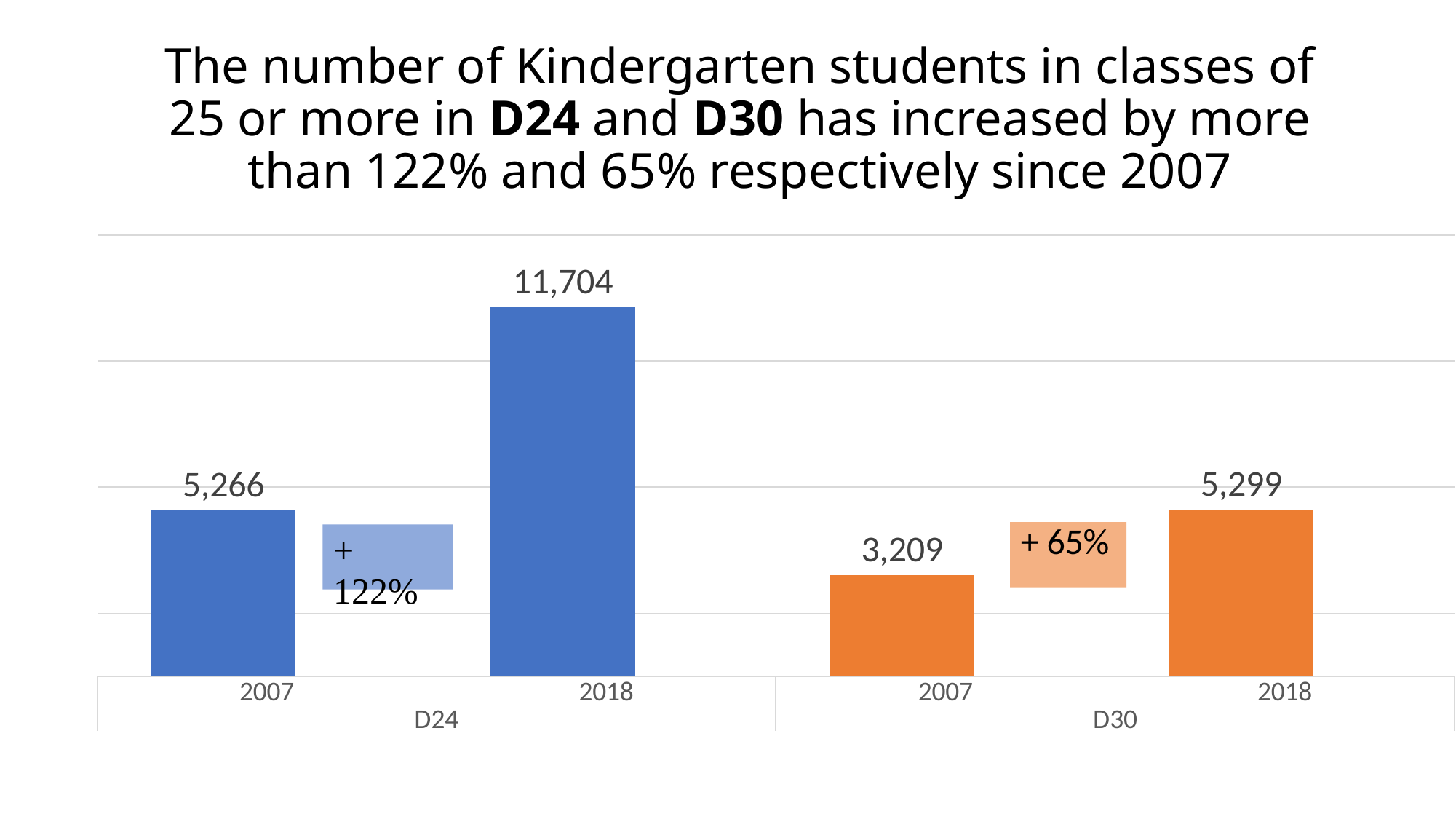
What is the value for D30 in 2007? 3,209 What is the value for D24 in 2018? 11,704 What is the difference between the D24 values for 2018 and 2007? 6,438 What is the value for D30 in 2018? 5,299 How many bars are plotted in the chart? 4 Which bar has the lowest value? D30 2007 What kind of chart is shown? Bar chart What is the difference between the D30 values for 2018 and 2007? 2,090 What is the value for D24 in 2007? 5,266 What percentage increase is annotated for D30? + 65% Which bar has the highest value? D24 2018 Which is larger, the D24 value for 2007 or the D30 value for 2018? D30 2018